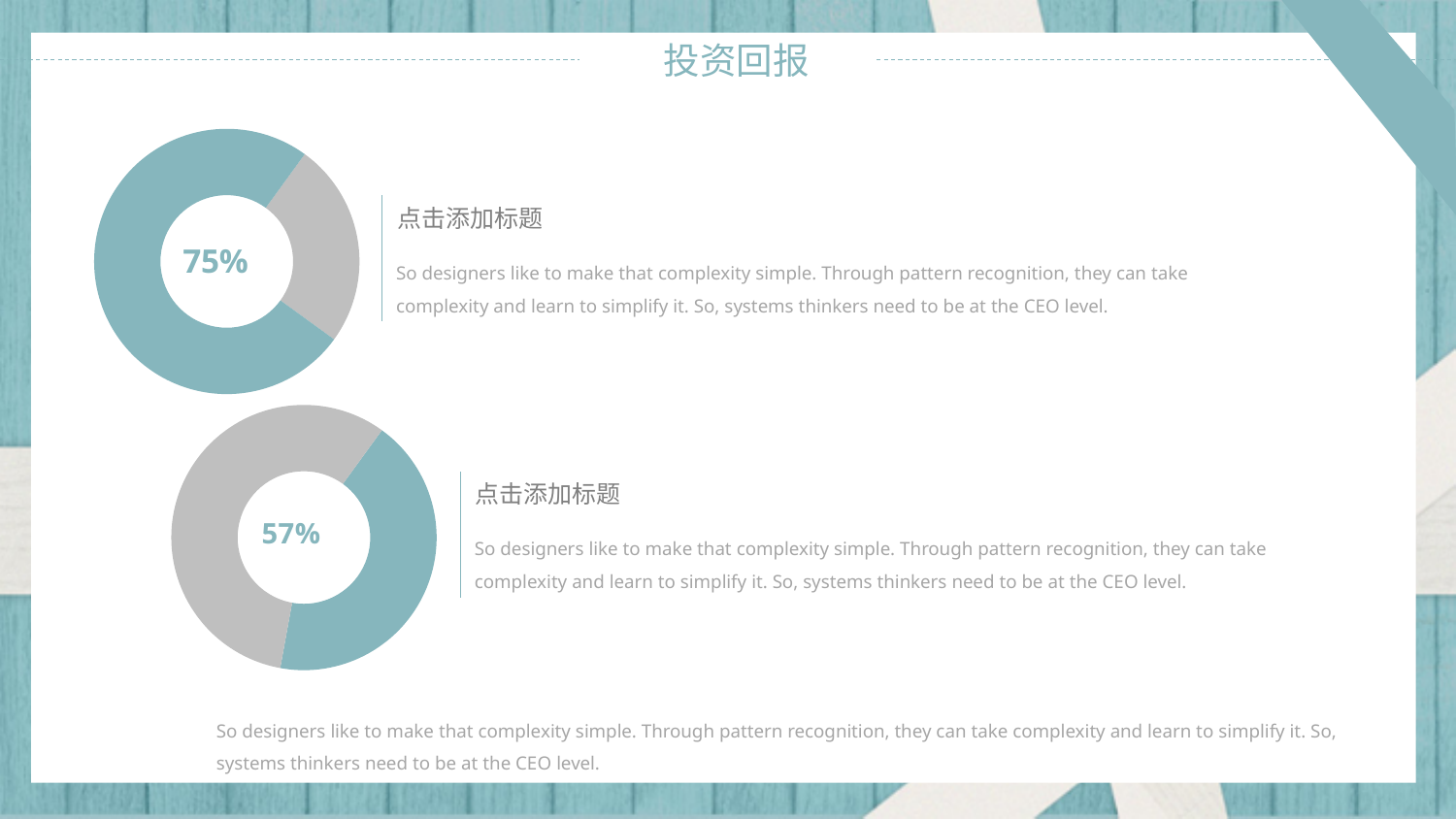
What two colours are used for the segments of the donut charts? Teal and grey What kind of chart is the bottom chart on the slide? Donut chart What percentage is shown in the centre of the bottom donut chart? 57% Which chart shows the larger percentage, the top donut chart or the bottom donut chart? The top donut chart What is the title of the slide containing the two donut charts? 投资回报 What percentage is shown in the centre of the top donut chart? 75% In the bottom donut chart, what share of the ring is filled by the teal segment? 57% Is the value shown in the bottom donut chart greater or less than 50%? greater What kind of chart is the top chart on the slide? Donut chart What is the difference between the percentage in the top donut chart and the percentage in the bottom donut chart? 18% How many donut charts are on the slide? 2 In the top donut chart, what share of the ring is filled by the teal segment? 75%